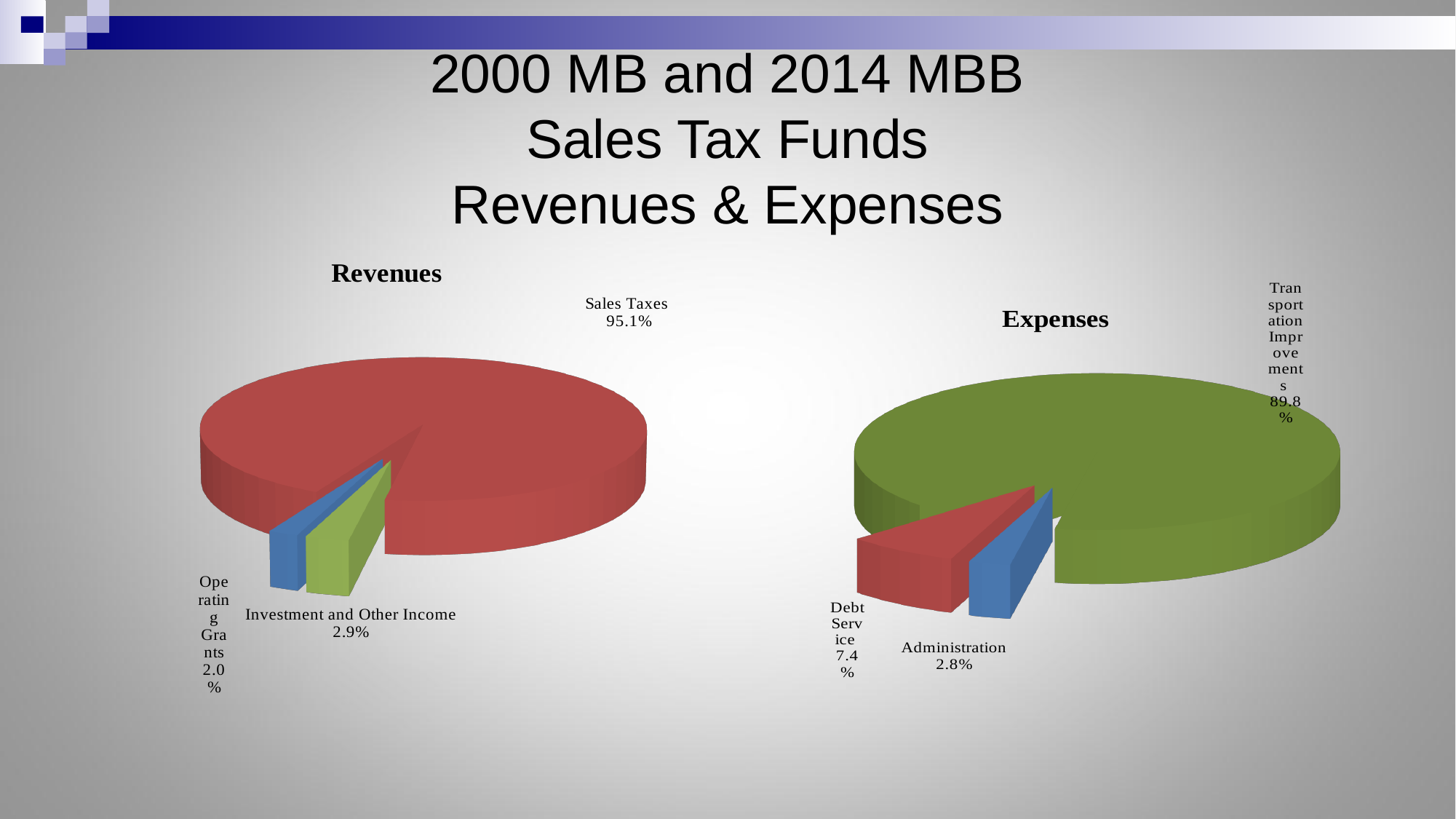
What type of chart is the Revenues chart? Pie chart In the Revenues chart, which is larger, Investment and Other Income or Operating Grants? Investment and Other Income How many slices does the Expenses chart have? 3 In the Revenues chart, what share does Investment and Other Income have? 2.9% In the Expenses chart, which category has the smallest slice? Administration In the Expenses chart, what share does Administration have? 2.8% In the Expenses chart, what share does Debt Service have? 7.4% In the Expenses chart, what is the difference between Debt Service and Administration? 4.6% In the Revenues chart, what share does Sales Taxes have? 95.1% In the Revenues chart, which category has the largest slice? Sales Taxes In the Revenues chart, what share does Operating Grants have? 2.0% In the Expenses chart, what share does Transportation Improvements have? 89.8%